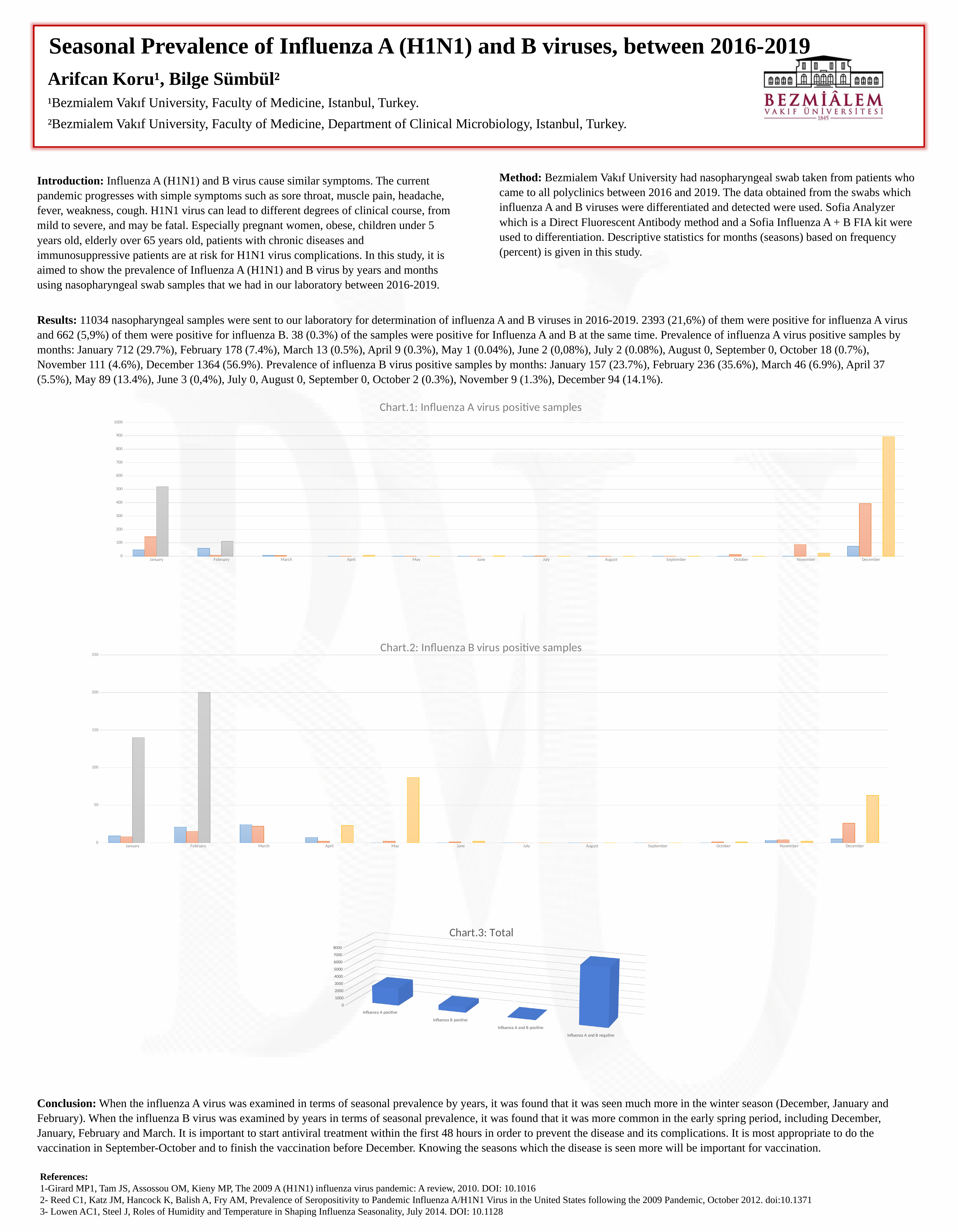
How many categories are shown in Chart.3: Total? 4 In Chart.1: Influenza A virus positive samples, which month has the tallest bar? December In Chart.3: Total, which category has the highest value? Influenza A and B negative In Chart.3: Total, which category has the lowest value? Influenza A and B positive In Chart.2: Influenza B virus positive samples, is the tallest January bar greater or less than 100? greater What kind of chart is Chart.1: Influenza A virus positive samples? bar chart In Chart.3: Total, is the value for Influenza B positive greater or less than 1000? less In Chart.2: Influenza B virus positive samples, is the tallest May bar greater or less than 50? greater In Chart.2: Influenza B virus positive samples, which month has the tallest bar? February In Chart.1: Influenza A virus positive samples, is the tallest bar for December larger or smaller than the tallest bar for January? larger How many months are shown on the x axis of Chart.1: Influenza A virus positive samples? 12